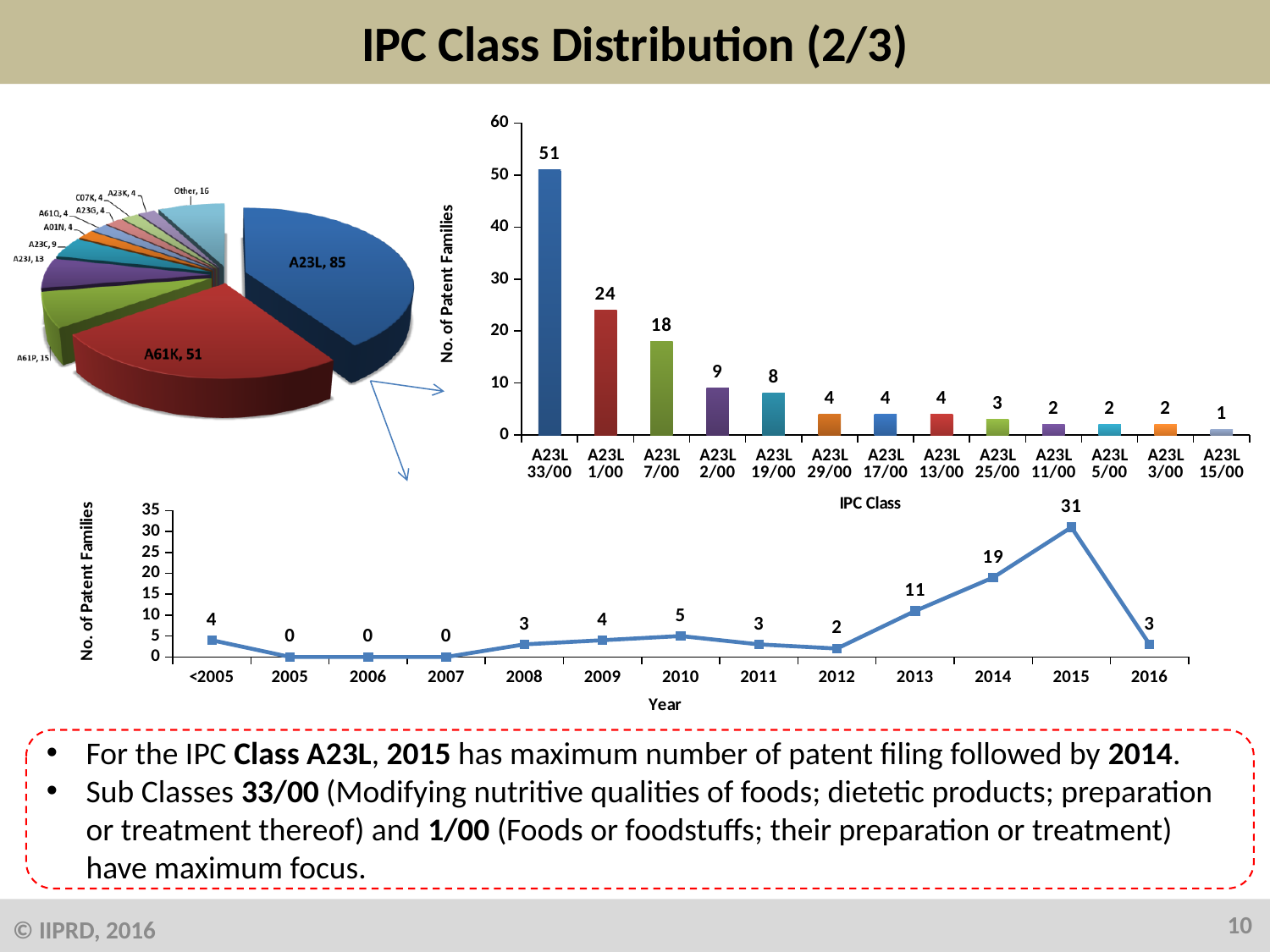
In the pie chart on the top left, what is the value for A61K? 51 In the line chart at the bottom, do the values rise or fall from 2012 to 2015? rise What kind of chart is shown on the top left of the slide? pie chart In the line chart at the bottom, what is the value for 2016? 3 In the bar chart on the top right, which IPC class has the lowest number of patent families? A23L 15/00 In the bar chart on the top right, what is the difference between the values for A23L 1/00 and A23L 7/00? 6 In the line chart at the bottom, which year has the highest number of patent families? 2015 In the bar chart on the top right, which is larger, the value for A23L 2/00 or A23L 19/00? A23L 2/00 In the line chart at the bottom, what is the number of patent families for 2015? 31 In the line chart at the bottom, what is the difference between the values for 2015 and 2014? 12 In the bar chart on the top right, what is the number of patent families for A23L 33/00? 51 In the bar chart on the top right, how many IPC classes are shown on the x axis? 13